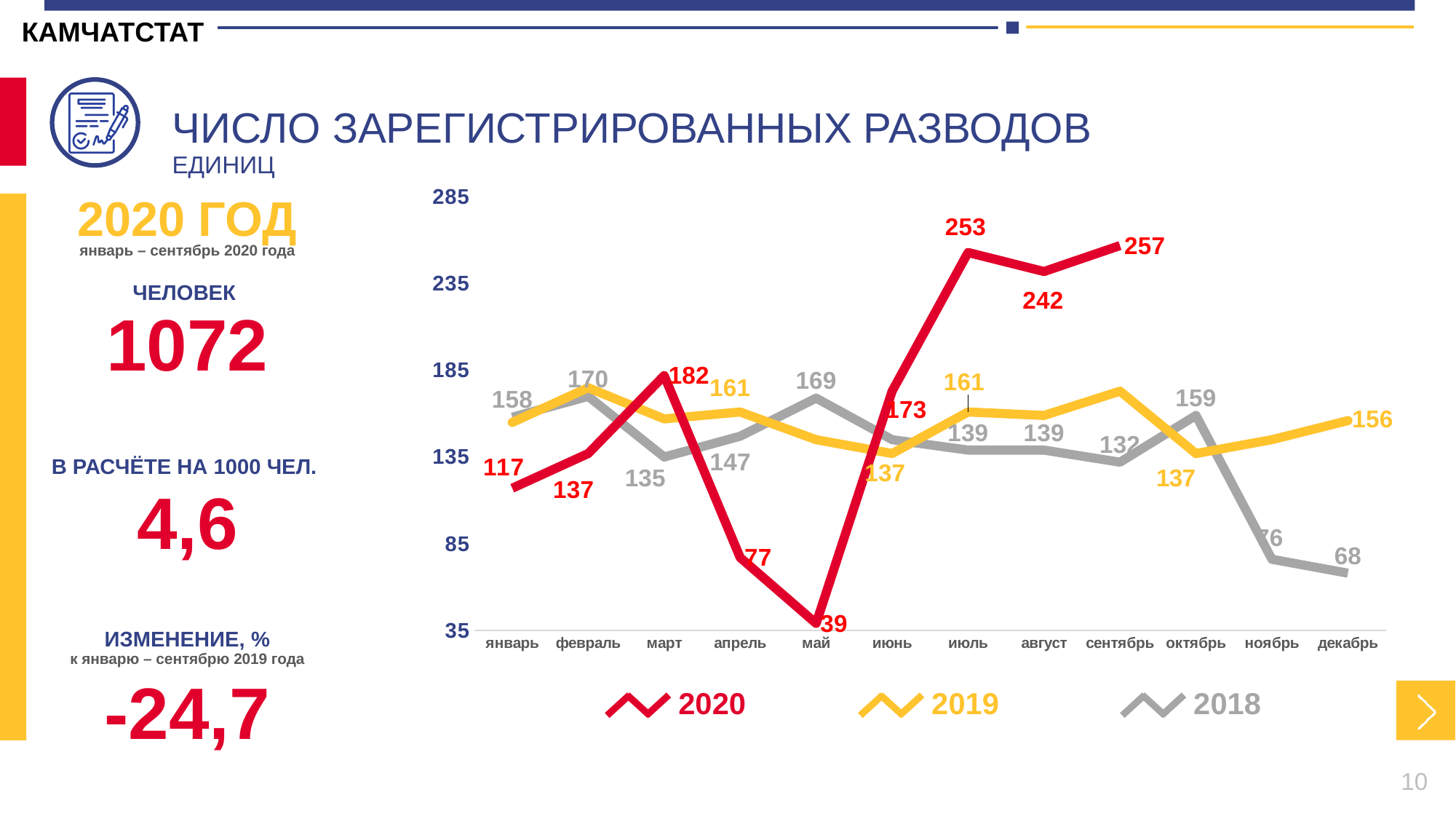
Does the 2018 series rise or fall from October (октябрь) to December (декабрь)? fall What is the difference between the 2020 values for July (июль) and August (август)? 11 What is the value for the 2018 series in February (февраль)? 170 What type of chart is shown on the slide? line chart What is the value for the 2018 series in December (декабрь)? 68 What is the value for the 2020 series in May (май)? 39 What is the value for the 2020 series in September (сентябрь)? 257 Which is larger in March (март): the 2020 value or the 2018 value? 2020 How many series does the legend list? 3 Is the value for the 2019 series in January (январь) greater or less than 135? greater In which month does the 2020 series reach its lowest value? май In which month does the 2020 series reach its highest value? сентябрь